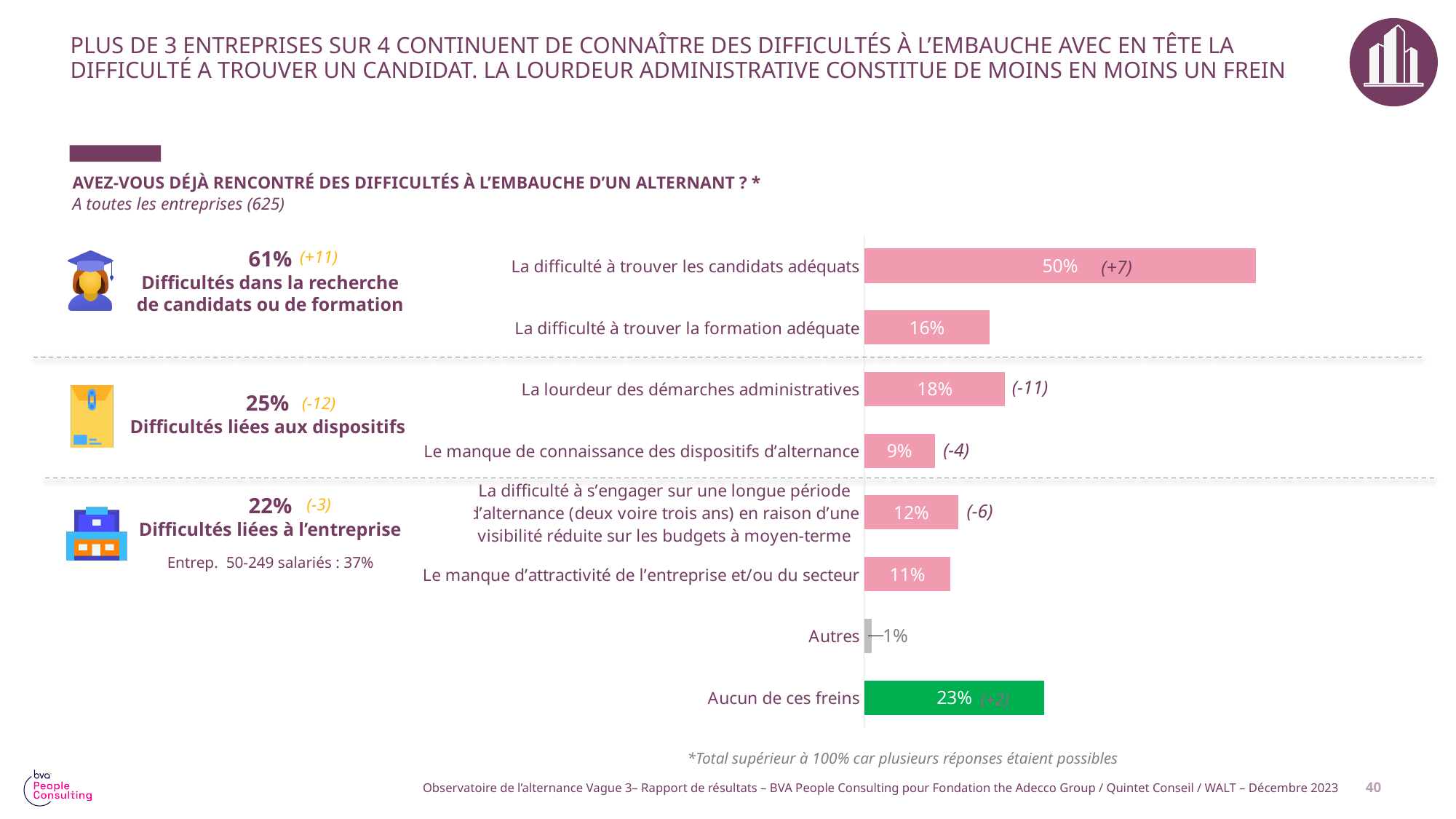
Which is larger: the value for "La lourdeur des démarches administratives" or the value for "La difficulté à trouver la formation adéquate"? La lourdeur des démarches administratives How many categories are plotted in the bar chart? 8 What is the value shown for "Le manque de connaissance des dispositifs d'alternance"? 9% Which bar in the chart is coloured green rather than pink? Aucun de ces freins What percentage of companies cite "La difficulté à trouver les candidats adéquats" as a difficulty? 50% What is the value shown for "Aucun de ces freins"? 23% What is the difference between the values for "La difficulté à trouver les candidats adéquats" and "La difficulté à trouver la formation adéquate"? 34% What kind of chart is shown on the slide? Bar chart What is the change indicated in parentheses next to the 50% bar for "La difficulté à trouver les candidats adéquats"? (+7) Which category has the highest value in the bar chart? La difficulté à trouver les candidats adéquats What is the value shown for "La lourdeur des démarches administratives"? 18% Which category has the lowest value in the bar chart? Autres